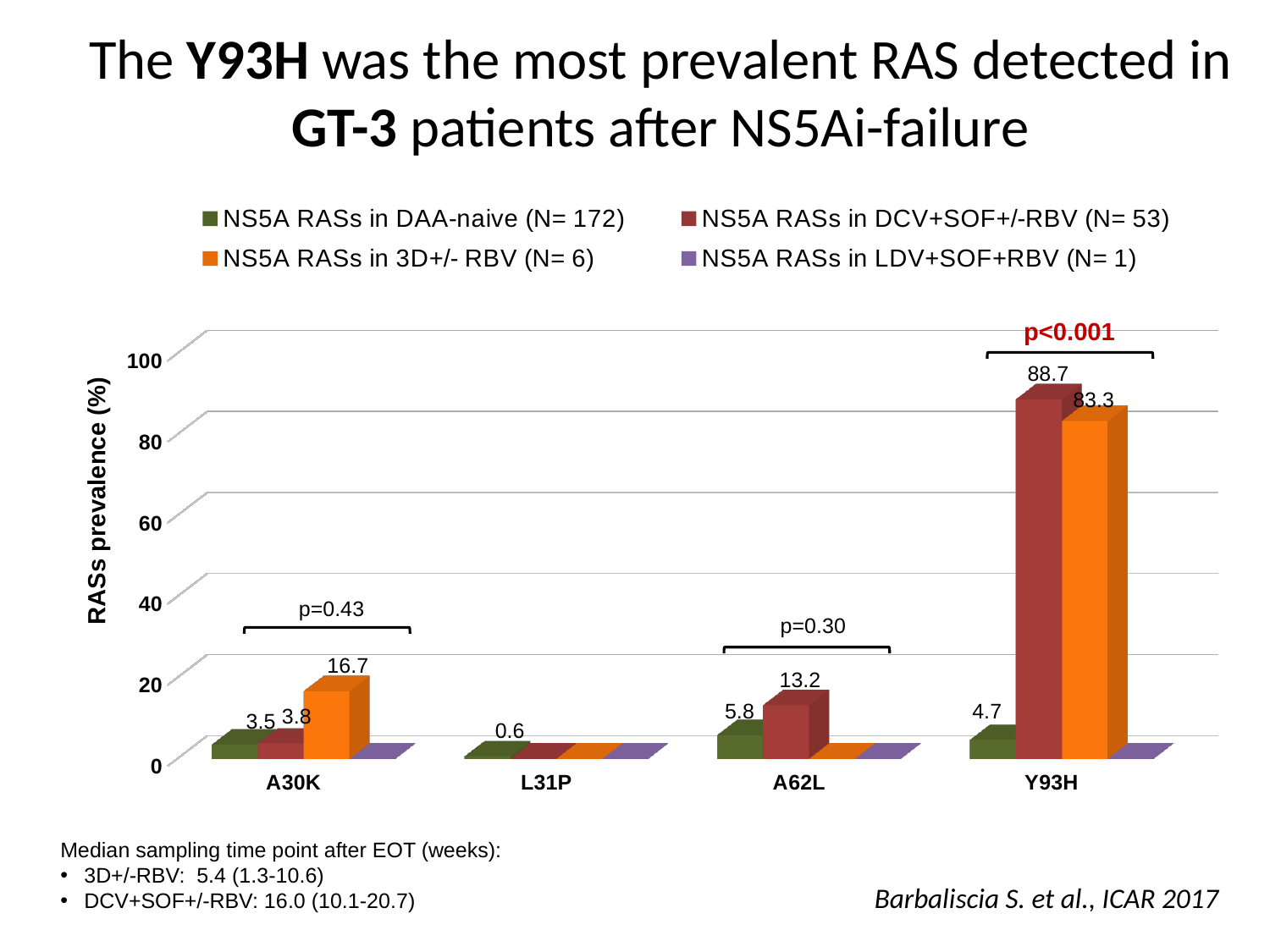
What is the RASs prevalence for A30K in the NS5A RASs in 3D+/- RBV (N= 6) series? 16.7 How many series does the legend list? 4 What kind of chart is shown on the slide? Bar chart For A62L, which series has the larger value: NS5A RASs in DAA-naive (N= 172) or NS5A RASs in DCV+SOF+/-RBV (N= 53)? NS5A RASs in DCV+SOF+/-RBV (N= 53) What is the RASs prevalence for A62L in the NS5A RASs in DAA-naive (N= 172) series? 5.8 Is the value for Y93H in the NS5A RASs in 3D+/- RBV (N= 6) series greater or less than 80? greater How many RAS categories are shown on the x axis? 4 Which RAS has the lowest prevalence in the NS5A RASs in DAA-naive (N= 172) series? L31P Which RAS has the highest prevalence in the NS5A RASs in DCV+SOF+/-RBV (N= 53) series? Y93H What is the RASs prevalence for L31P in the NS5A RASs in DAA-naive (N= 172) series? 0.6 What is the RASs prevalence for Y93H in the NS5A RASs in DCV+SOF+/-RBV (N= 53) series? 88.7 What is the difference between the DCV+SOF+/-RBV and DAA-naive prevalence values for Y93H? 84.0